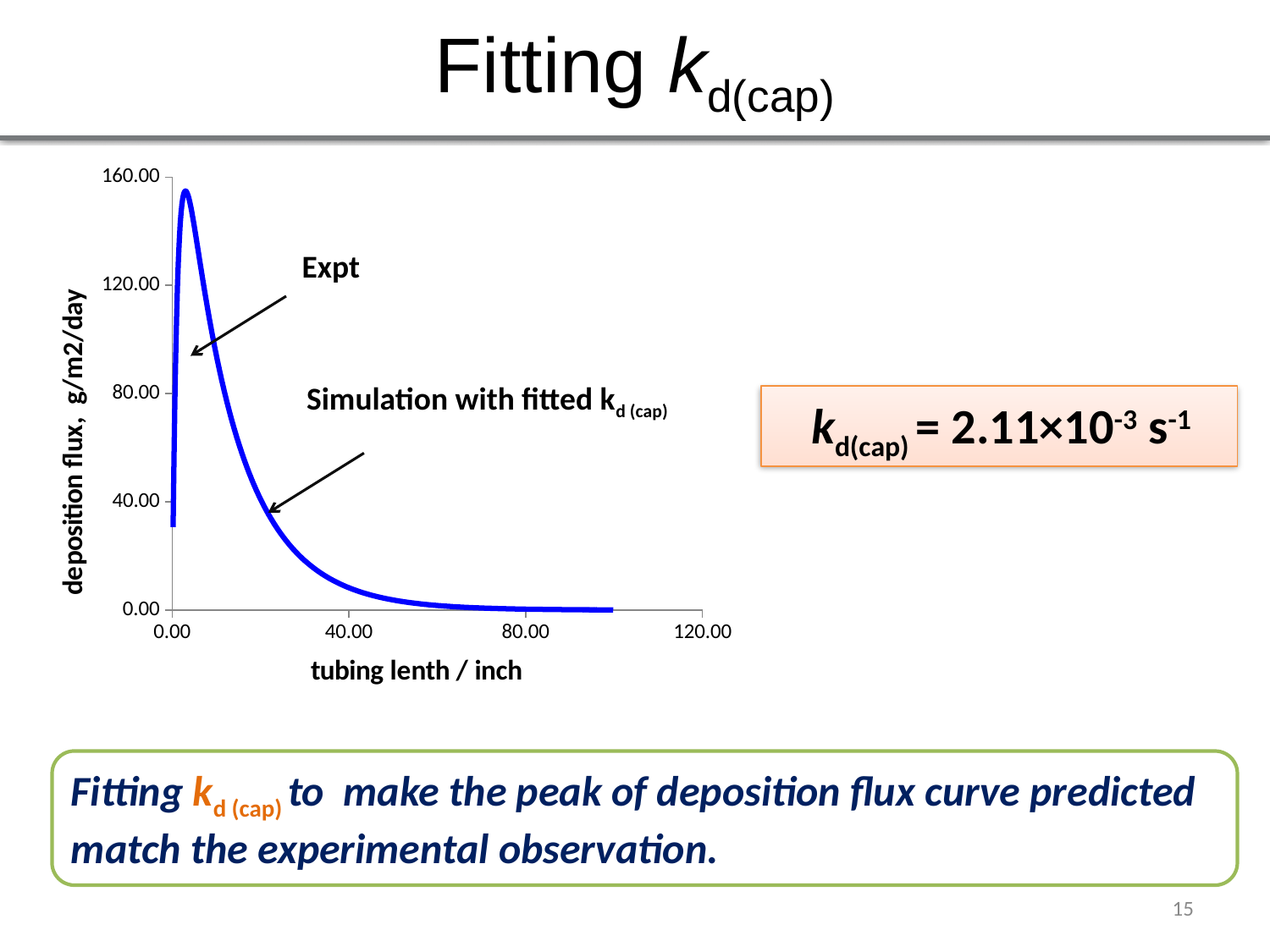
Is the deposition flux at a tubing length of 40 inches greater or less than 40? less Is the deposition flux at a tubing length of 60 inches greater or less than 80? less What kind of chart is shown on the slide? line chart Is the peak value of the deposition flux curve greater or less than 120? greater What is the title of the x axis of the chart? tubing lenth / inch What is the title of the y axis of the chart? deposition flux, g/m2/day After its peak, does the deposition flux curve rise or fall as tubing length increases? fall